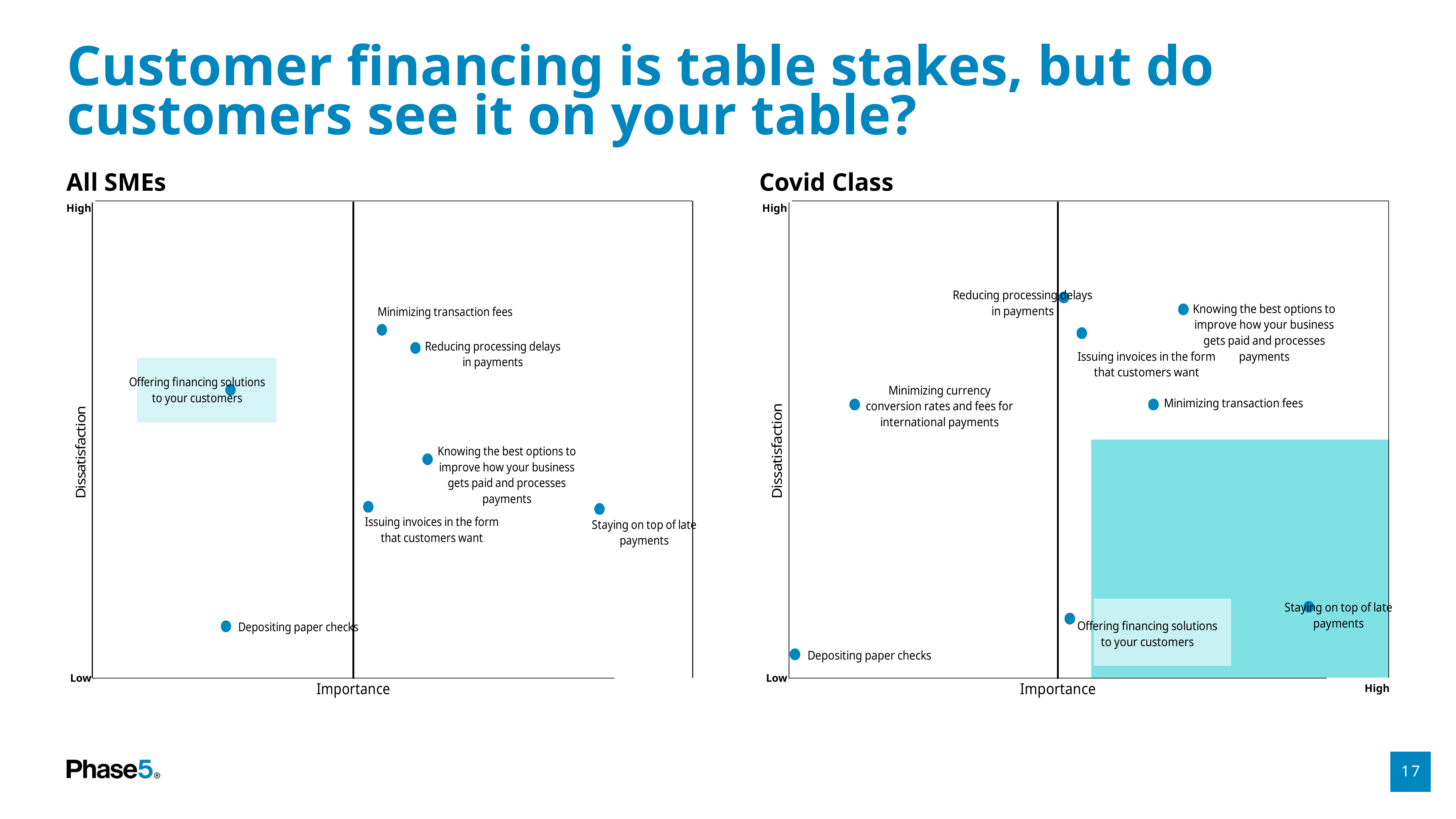
On the Covid Class chart, which has higher importance: Minimizing currency conversion rates and fees for international payments or Minimizing transaction fees? Minimizing transaction fees What kind of chart is the All SMEs chart? Scatter chart On the All SMEs chart, which item has the lowest dissatisfaction? Depositing paper checks What is the label of the vertical axis on the Covid Class chart? Dissatisfaction On the Covid Class chart, which item has the highest importance? Staying on top of late payments How many data points are plotted on the All SMEs chart? 7 On the Covid Class chart, which item has the lowest importance? Depositing paper checks On the Covid Class chart, which item has the lowest dissatisfaction? Depositing paper checks On the All SMEs chart, which item has the highest dissatisfaction? Minimizing transaction fees On the All SMEs chart, which item has the highest importance? Staying on top of late payments How many data points are plotted on the Covid Class chart? 8 On the All SMEs chart, which has higher dissatisfaction: Offering financing solutions to your customers or Depositing paper checks? Offering financing solutions to your customers